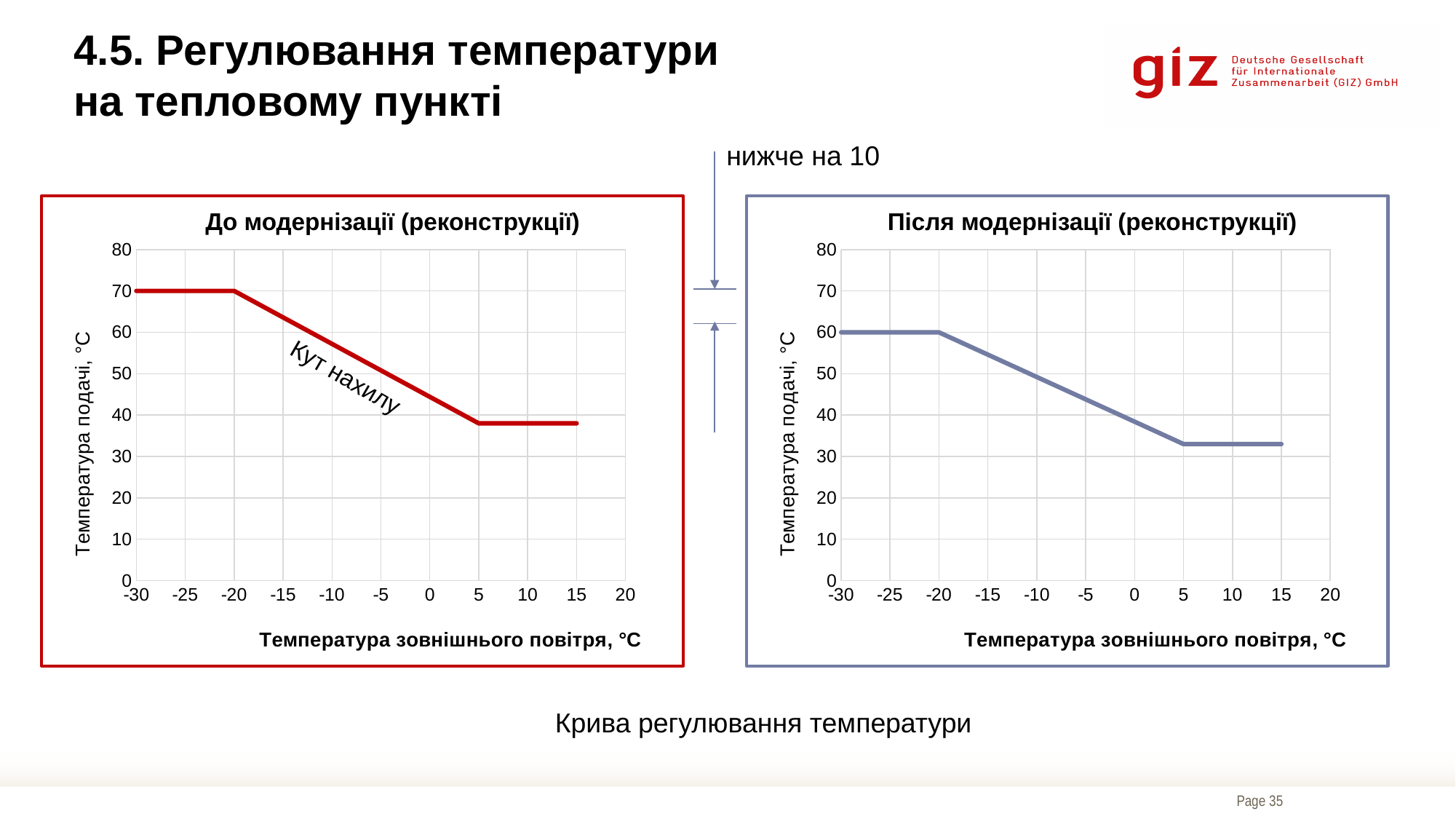
In the 'Після модернізації (реконструкції)' chart, what is the supply temperature at an outdoor temperature of -20 °C? 60 In the 'До модернізації (реконструкції)' chart, is the supply temperature at an outdoor temperature of 10 °C greater or less than 40? less How many tick marks are labelled on the x axis of the 'До модернізації (реконструкції)' chart? 11 In the 'Після модернізації (реконструкції)' chart, is the supply temperature at an outdoor temperature of -10 °C greater or less than 40? greater Which chart has the higher supply temperature at an outdoor temperature of -25 °C, 'До модернізації (реконструкції)' or 'Після модернізації (реконструкції)'? До модернізації (реконструкції) In the 'До модернізації (реконструкції)' chart, what is the supply temperature at an outdoor temperature of -30 °C? 70 What text is written along the sloping part of the line in the 'До модернізації (реконструкції)' chart? Кут нахилу In the 'Після модернізації (реконструкції)' chart, is the supply temperature at an outdoor temperature of 15 °C greater or less than 30? greater What is the x-axis label of the 'Після модернізації (реконструкції)' chart? Температура зовнішнього повітря, °C What is the difference between the supply temperature at -30 °C in the 'До модернізації (реконструкції)' chart and in the 'Після модернізації (реконструкції)' chart? 10 In the 'Після модернізації (реконструкції)' chart, does the supply temperature rise or fall as the outdoor temperature increases from -20 °C to 5 °C? fall What kind of chart is the 'До модернізації (реконструкції)' chart? line chart